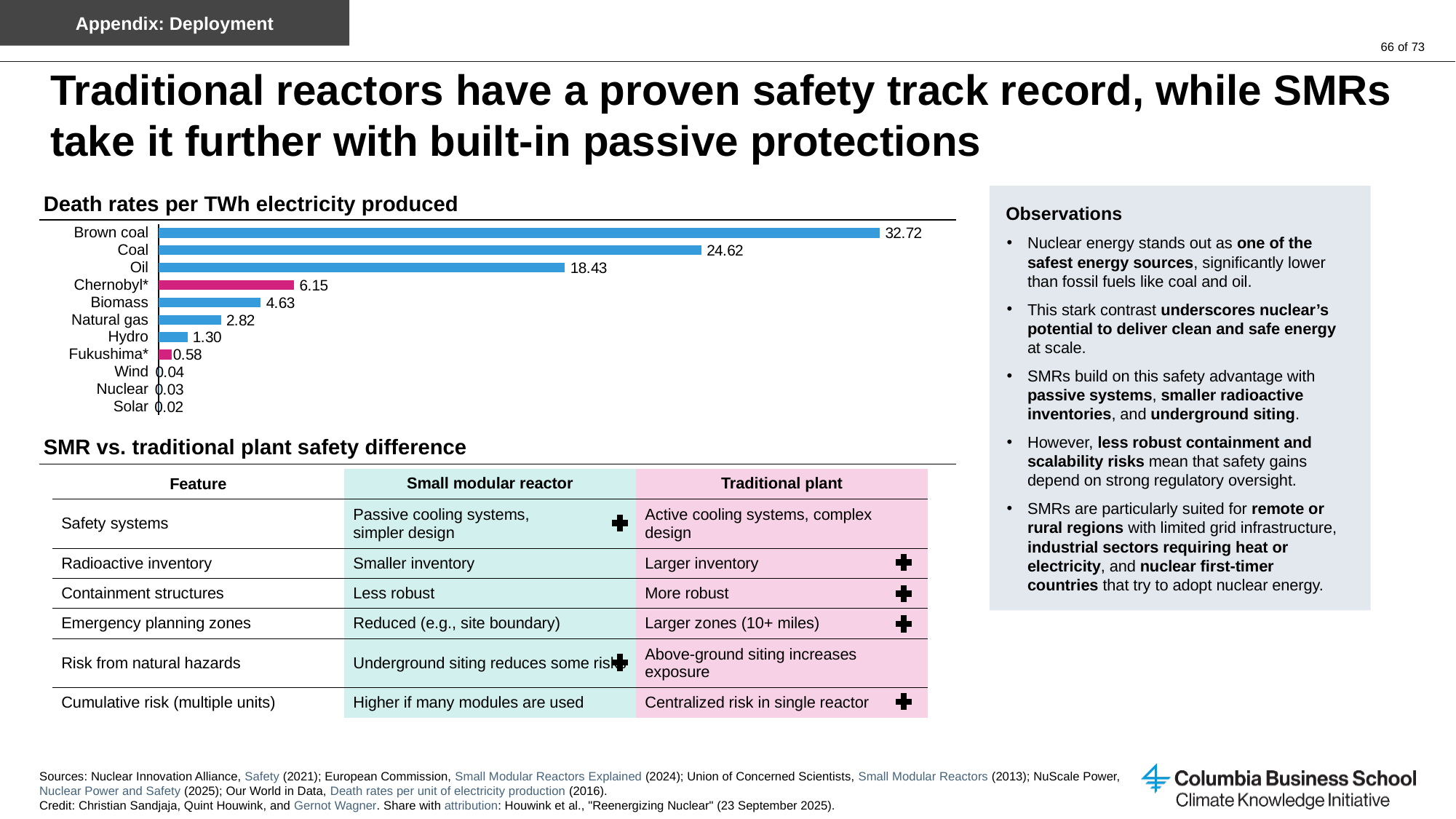
Which category has the highest death rate per TWh? Brown coal What is the death rate per TWh for Brown coal? 32.72 Which has a higher death rate per TWh, Hydro or Fukushima*? Hydro What is the difference between the death rates for Coal and Oil? 6.19 What is the difference between the death rates for Chernobyl* and Biomass? 1.52 What is the title of the chart on the slide? Death rates per TWh electricity produced Which category has the lowest death rate per TWh? Solar What is the death rate per TWh for Nuclear? 0.03 How many categories are shown in the death rates chart? 11 Which two categories in the death rates chart are shown in a different colour (pink) from the rest? Chernobyl* and Fukushima* What kind of chart is used to show death rates per TWh? Bar chart What is the death rate per TWh for Natural gas? 2.82